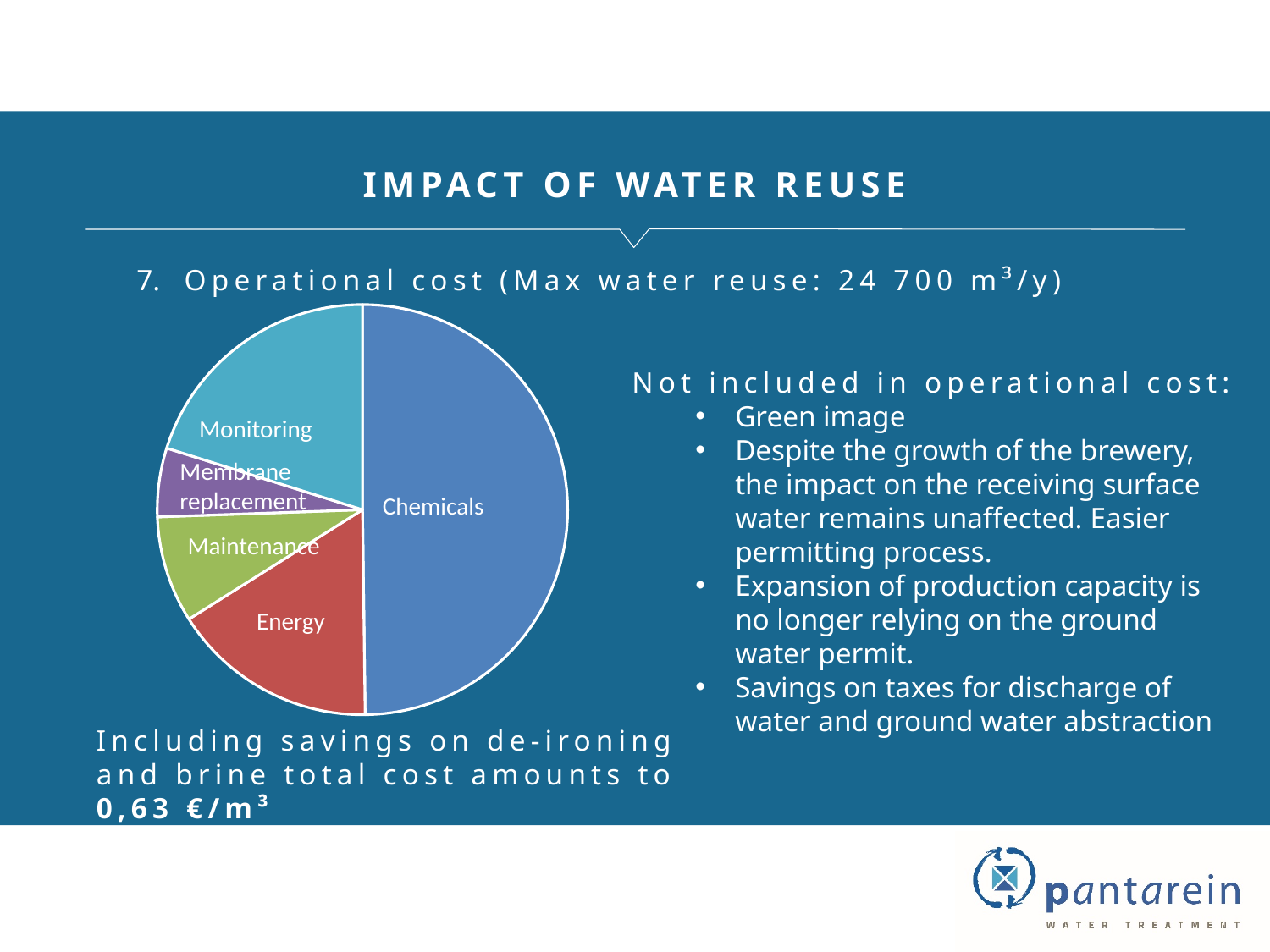
Which category has the smallest slice of the pie chart? Membrane replacement What colour is the Maintenance slice of the pie chart? green Which slice is larger, Monitoring or Membrane replacement? Monitoring Which category has the largest slice of the pie chart? Chemicals Which slice is larger, Monitoring or Maintenance? Monitoring What colour is the Energy slice of the pie chart? red Which slice is larger, Energy or Maintenance? Energy What kind of chart is shown on the slide? pie chart How many slices does the pie chart have? 5